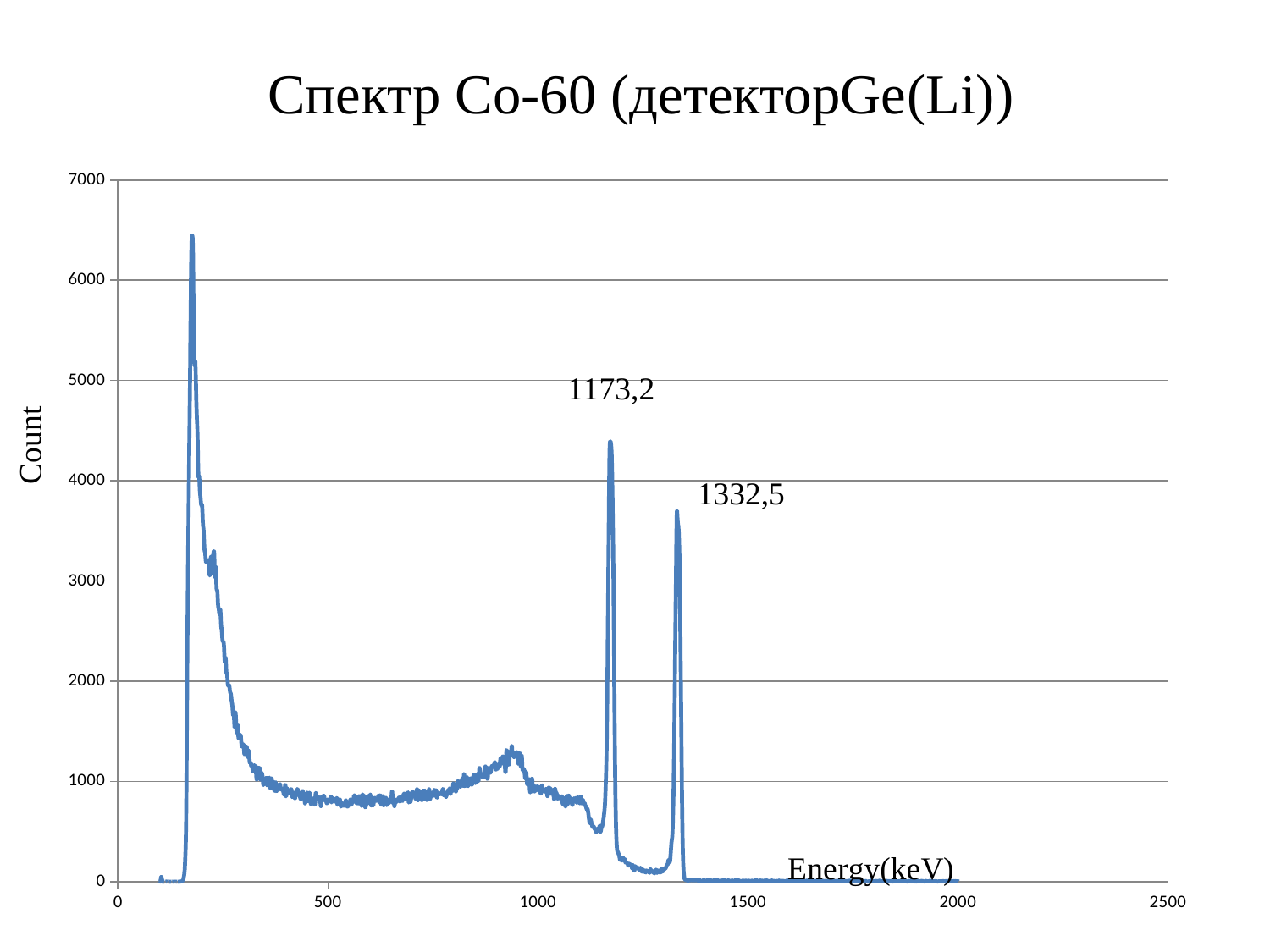
What kind of chart is shown on the slide? line chart What energy value is written next to the first of the two labeled peaks? 1173,2 Which labeled peak has the higher count, 1173,2 or 1332,5? 1173,2 Is the count at the peak labeled 1173,2 greater or less than 4000? greater Is the count at 500 keV greater or less than 1000? less Is the count at the highest peak of the spectrum (near 200 keV) greater or less than 6000? greater What is the maximum value shown on the vertical axis? 7000 What energy value is written next to the second of the two labeled peaks? 1332,5 What is the label of the vertical axis? Count How many peaks are annotated with energy values on the chart? 2 What is the title of the chart? Спектр Co-60 (детекторGe(Li))